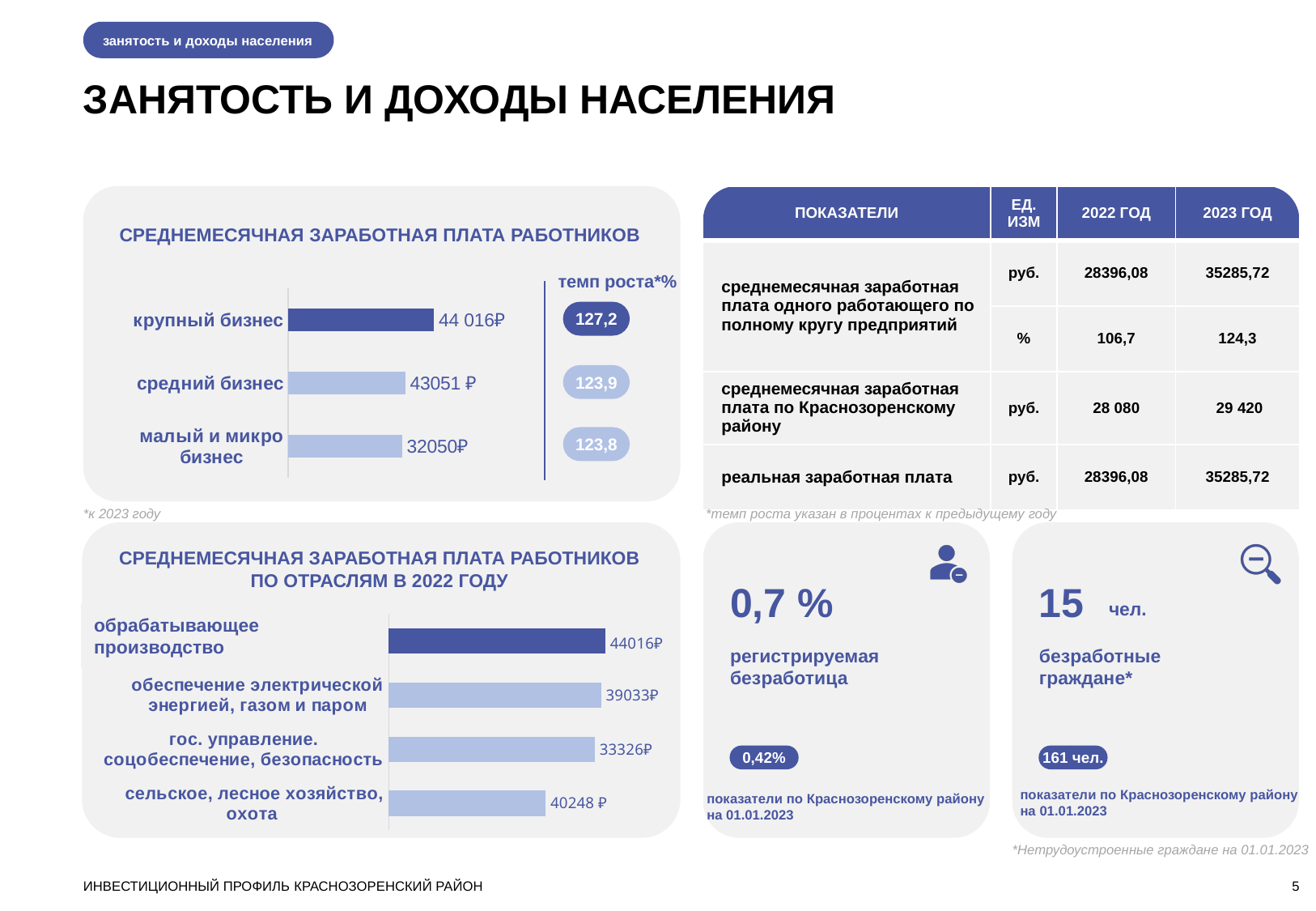
In the chart 'СРЕДНЕМЕСЯЧНАЯ ЗАРАБОТНАЯ ПЛАТА РАБОТНИКОВ', how many categories are shown? 3 In the chart 'СРЕДНЕМЕСЯЧНАЯ ЗАРАБОТНАЯ ПЛАТА РАБОТНИКОВ', what is the difference between the values for 'крупный бизнес' and 'малый и микро бизнес'? 11 966₽ In the chart 'СРЕДНЕМЕСЯЧНАЯ ЗАРАБОТНАЯ ПЛАТА РАБОТНИКОВ ПО ОТРАСЛЯМ В 2022 ГОДУ', what is the value for 'обеспечение электрической энергией, газом и паром'? 39033₽ In the chart 'СРЕДНЕМЕСЯЧНАЯ ЗАРАБОТНАЯ ПЛАТА РАБОТНИКОВ', what is the 'темп роста' value shown for 'средний бизнес'? 123,9 In the chart 'СРЕДНЕМЕСЯЧНАЯ ЗАРАБОТНАЯ ПЛАТА РАБОТНИКОВ ПО ОТРАСЛЯМ В 2022 ГОДУ', what is the value for 'сельское, лесное хозяйство, охота'? 40248 ₽ In the chart 'СРЕДНЕМЕСЯЧНАЯ ЗАРАБОТНАЯ ПЛАТА РАБОТНИКОВ ПО ОТРАСЛЯМ В 2022 ГОДУ', which category has the highest value? обрабатывающее производство What type of chart is 'СРЕДНЕМЕСЯЧНАЯ ЗАРАБОТНАЯ ПЛАТА РАБОТНИКОВ ПО ОТРАСЛЯМ В 2022 ГОДУ'? bar chart In the chart 'СРЕДНЕМЕСЯЧНАЯ ЗАРАБОТНАЯ ПЛАТА РАБОТНИКОВ ПО ОТРАСЛЯМ В 2022 ГОДУ', how many categories are shown? 4 In the chart 'СРЕДНЕМЕСЯЧНАЯ ЗАРАБОТНАЯ ПЛАТА РАБОТНИКОВ', which category has the lowest value? малый и микро бизнес In the chart 'СРЕДНЕМЕСЯЧНАЯ ЗАРАБОТНАЯ ПЛАТА РАБОТНИКОВ', what is the value for 'крупный бизнес'? 44 016₽ In the chart 'СРЕДНЕМЕСЯЧНАЯ ЗАРАБОТНАЯ ПЛАТА РАБОТНИКОВ', what is the value for 'малый и микро бизнес'? 32050₽